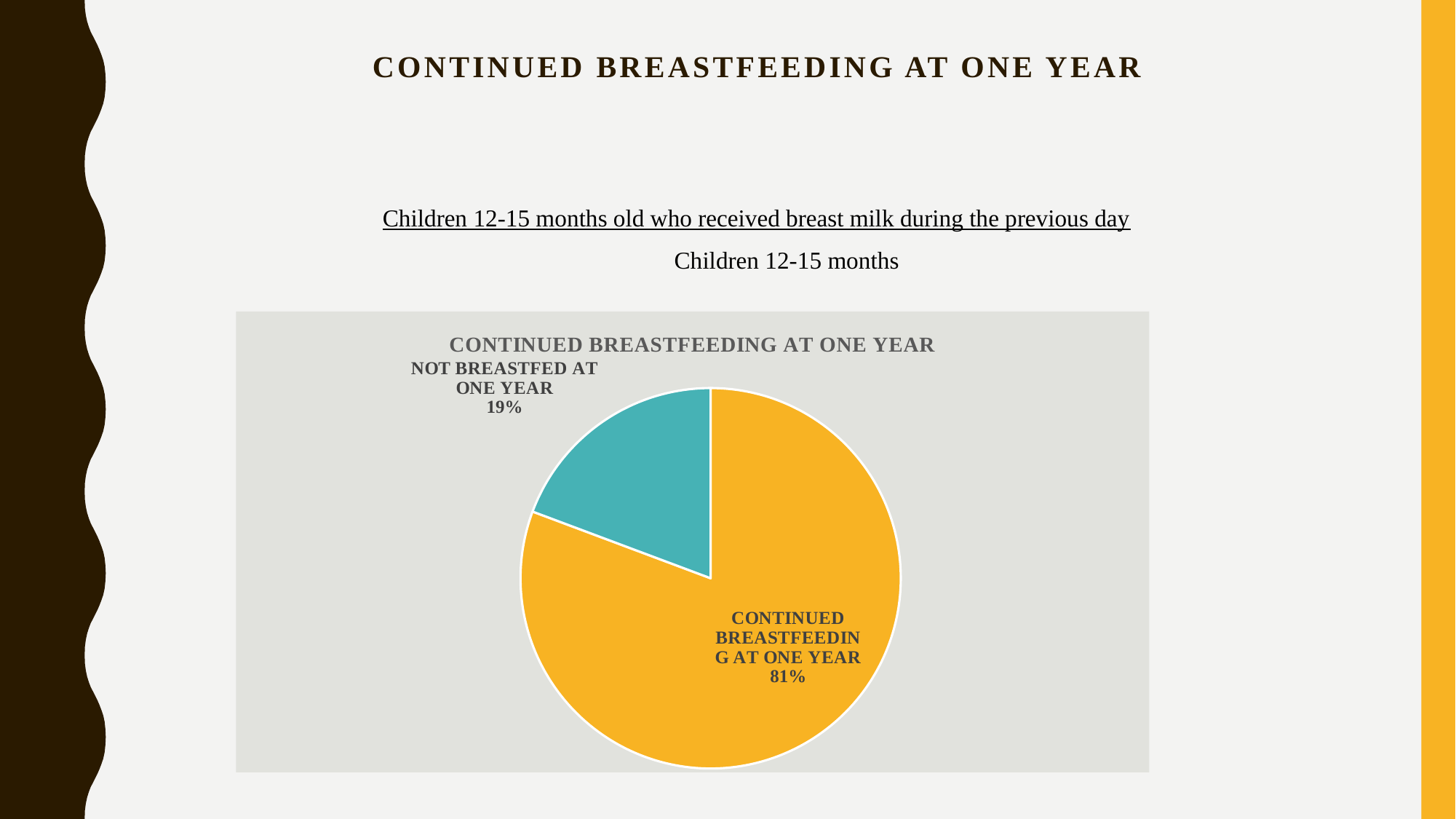
Which slice of the pie is the largest? CONTINUED BREASTFEEDING AT ONE YEAR Which is larger: the 'NOT BREASTFED AT ONE YEAR' slice or the 'CONTINUED BREASTFEEDING AT ONE YEAR' slice? CONTINUED BREASTFEEDING AT ONE YEAR What is the difference in percentage points between the 'CONTINUED BREASTFEEDING AT ONE YEAR' slice and the 'NOT BREASTFED AT ONE YEAR' slice? 62 What percentage of the pie is labelled 'NOT BREASTFED AT ONE YEAR'? 19% What share of the pie does the 'NOT BREASTFED AT ONE YEAR' slice represent? 19% Which slice of the pie is the smallest? NOT BREASTFED AT ONE YEAR What type of chart is shown on the slide? pie chart How many slices does the pie chart have? 2 What percentage of the pie is labelled 'CONTINUED BREASTFEEDING AT ONE YEAR'? 81% What is the title of the chart? CONTINUED BREASTFEEDING AT ONE YEAR What colour is the 'NOT BREASTFED AT ONE YEAR' slice? teal